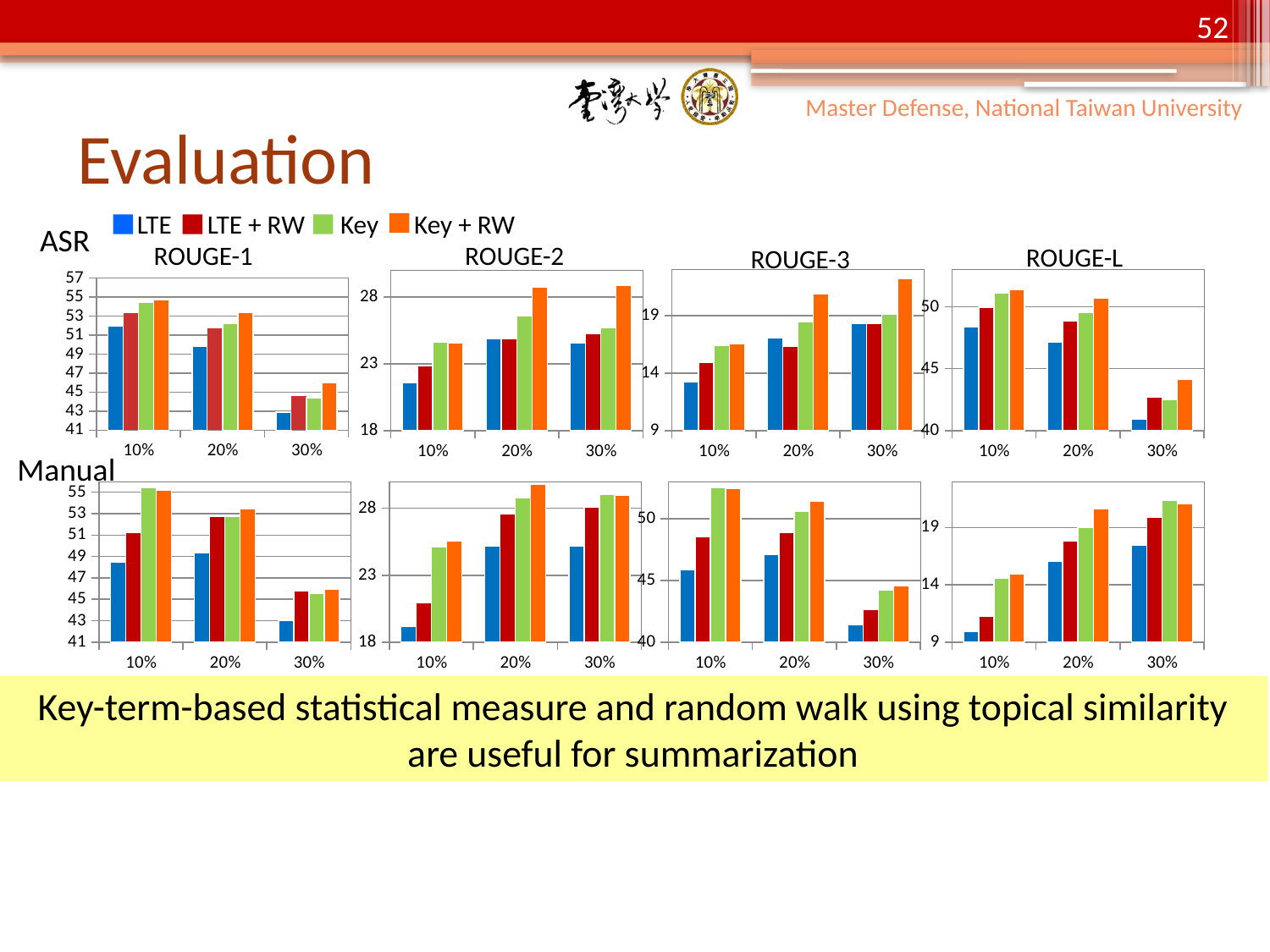
How many categories are shown on the x axis of the Manual ROUGE-2 chart (bottom row, second from left)? 3 How many series does the legend list for the charts on the slide? 4 In the ASR ROUGE-L chart (top right), which series has the lowest value at 30%? LTE In the ASR ROUGE-1 chart (top left), do the LTE values rise or fall from 10% to 30%? fall In the Manual ROUGE-L chart (bottom right), do the LTE values rise or fall from 10% to 30%? rise In the Manual ROUGE-1 chart (bottom left), which is larger at 10%: Key or LTE? Key In the ASR ROUGE-1 chart (top left), is the value for LTE at 30% greater or less than 45? less In the ASR ROUGE-3 chart (top row, third from left), which series has the highest value at 30%? Key + RW In the Manual ROUGE-2 chart (bottom row, second from left), is the value for Key + RW at 20% greater or less than 28? greater In the Manual ROUGE-3 chart (bottom row, third from left), is the value for LTE at 30% greater or less than 45? less What kind of chart is the ASR ROUGE-1 chart (top left)? bar chart